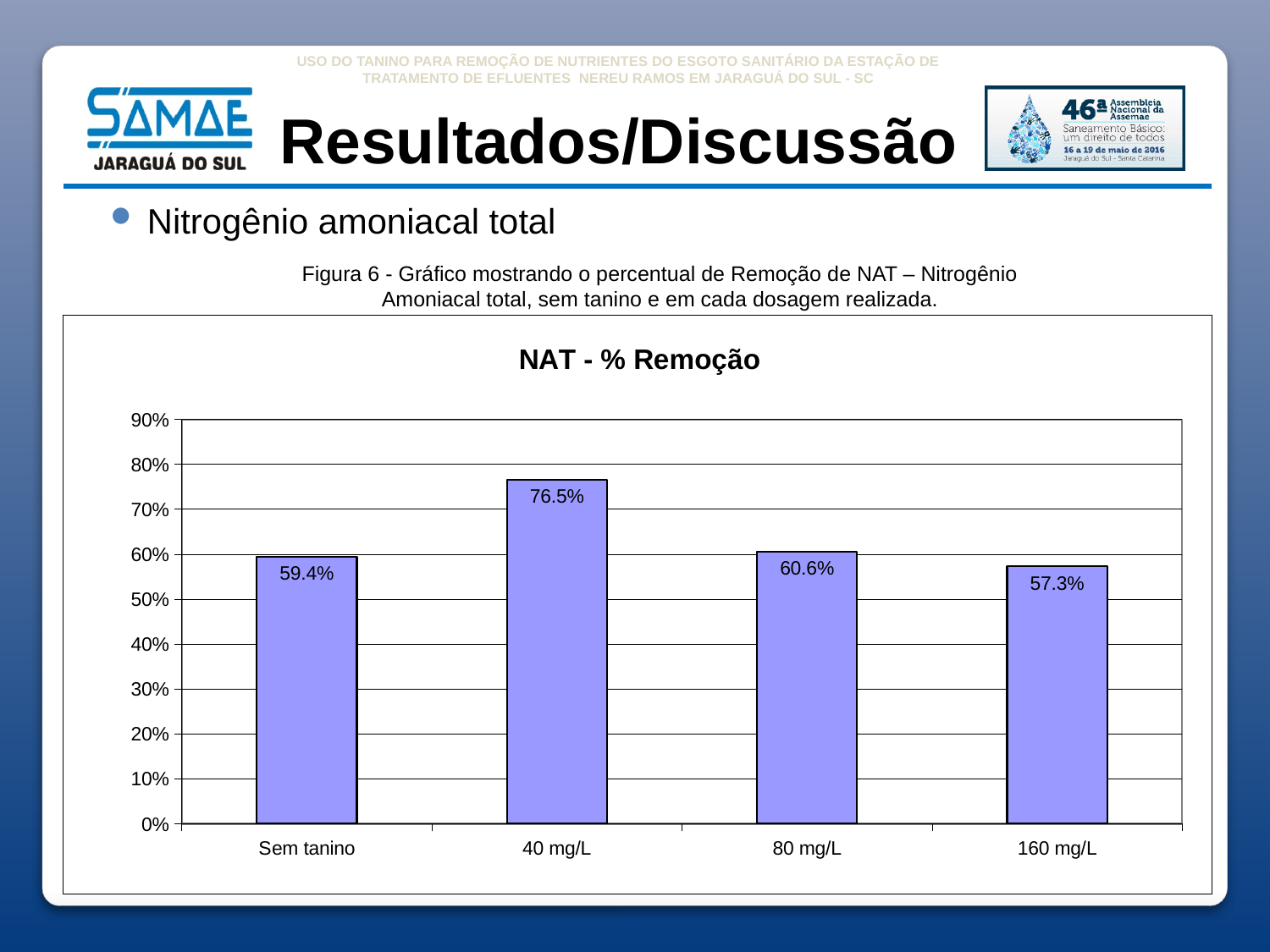
Is the value for 40 mg/L greater or less than 70%? greater What is the difference in removal percentage between 'Sem tanino' and 160 mg/L? 2.1% Which category has the highest NAT removal percentage? 40 mg/L How many categories are shown on the x axis of the chart? 4 Which has a higher removal percentage, 80 mg/L or 160 mg/L? 80 mg/L What is the title of the chart? NAT - % Remoção Which category has the lowest NAT removal percentage? 160 mg/L What kind of chart is shown on the slide? Bar chart What is the NAT removal percentage for 'Sem tanino'? 59.4% What is the difference in removal percentage between 40 mg/L and 80 mg/L? 15.9% What is the NAT removal percentage for the 160 mg/L dosage? 57.3% What is the NAT removal percentage for the 40 mg/L dosage? 76.5%